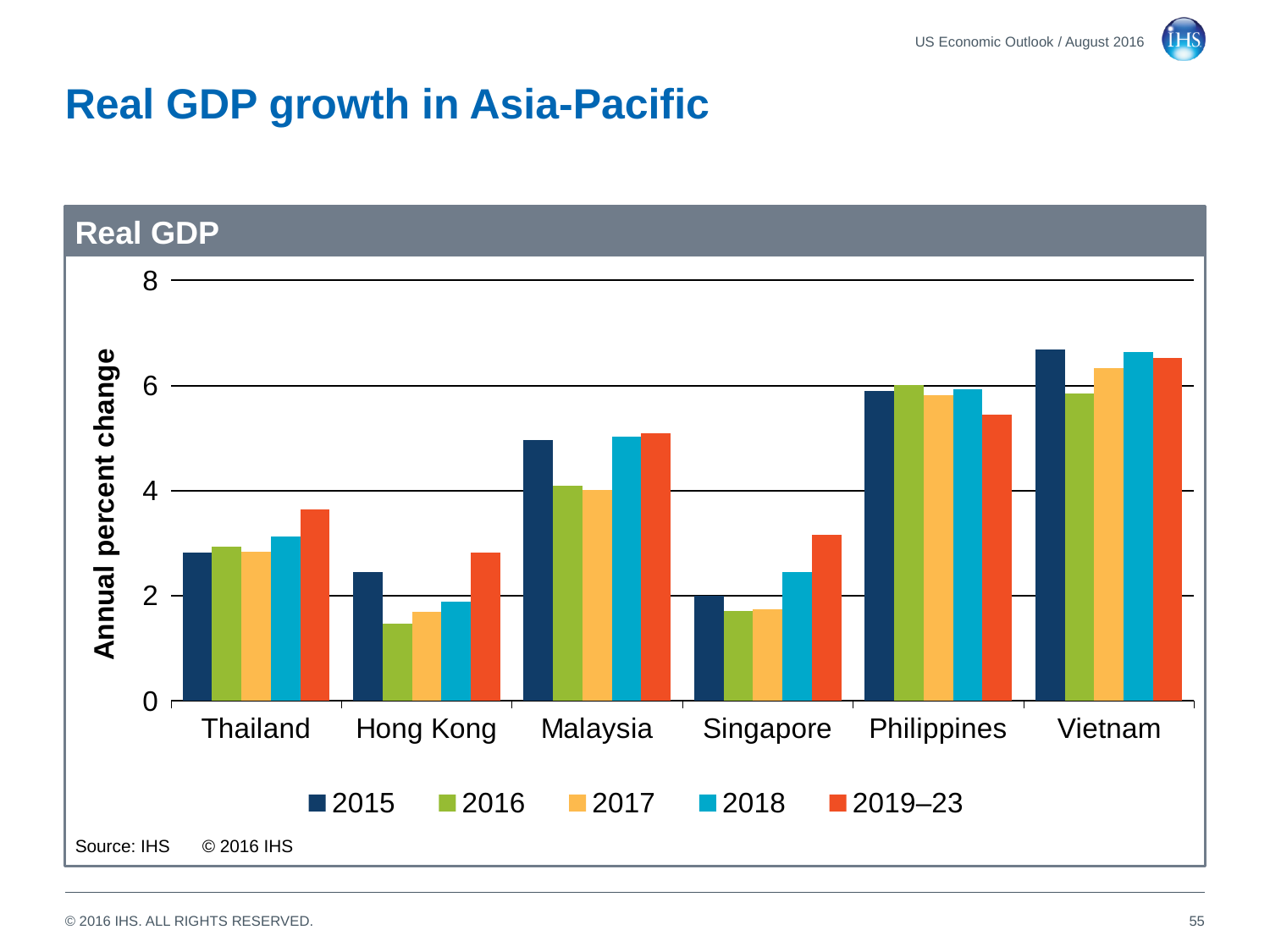
Is the 2015 value for Vietnam greater or less than 6? greater Is the 2016 value for Hong Kong greater or less than 2? less Which country has the lowest 2016 value? Hong Kong Which is larger: the 2019–23 value for Thailand or the 2019–23 value for Hong Kong? Thailand Which country has the highest 2015 value? Vietnam For Singapore, which is larger: the 2015 value or the 2019–23 value? 2019–23 Is the 2019–23 value for the Philippines greater or less than 6? less How many countries or regions are shown on the x axis of the chart? 6 What is the label on the vertical axis of the chart? Annual percent change How many series does the legend list? 5 What kind of chart is shown on the slide? Bar chart